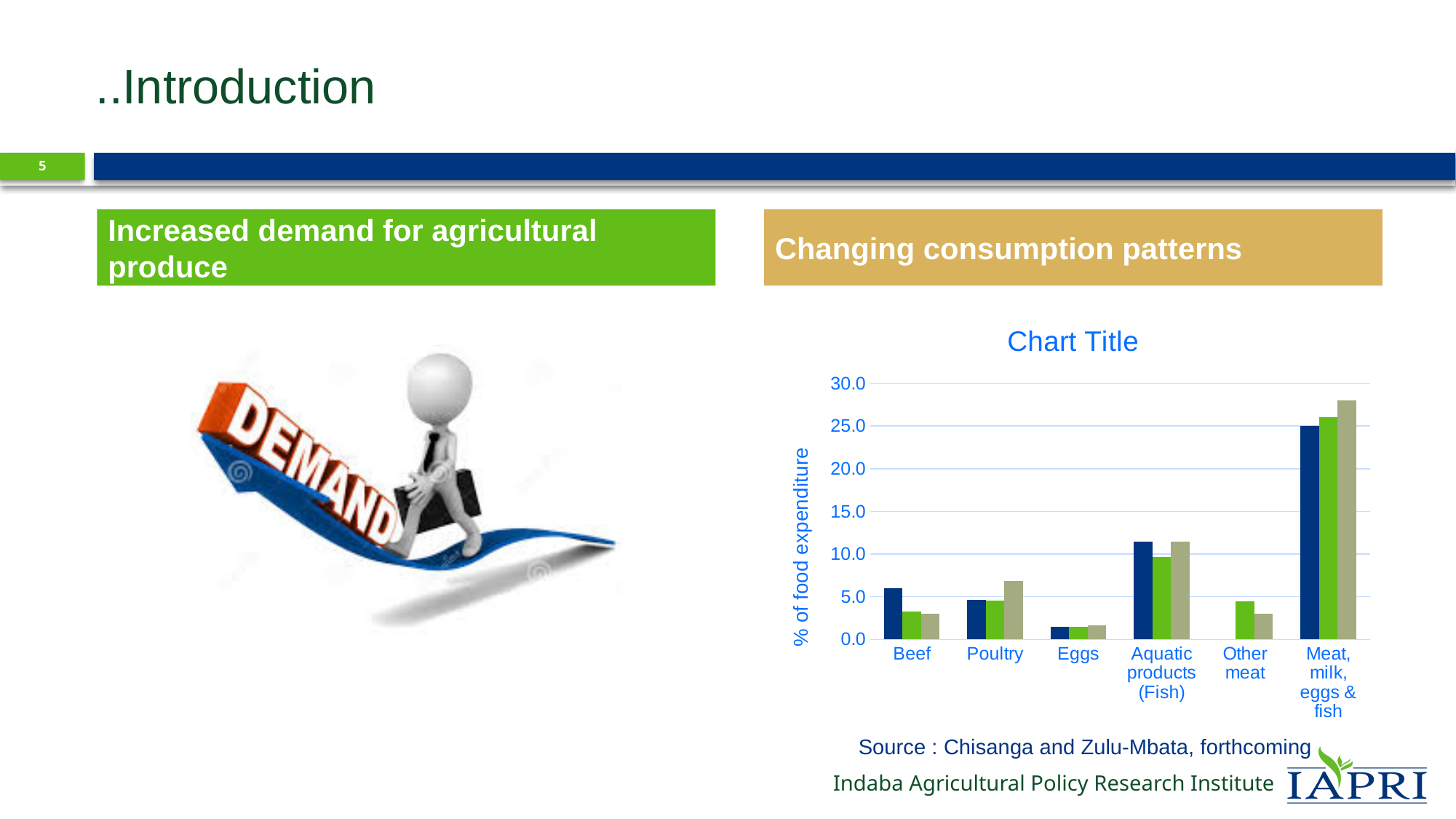
What is the title shown above the chart? Chart Title Which category has larger values, Meat, milk, eggs & fish or Beef? Meat, milk, eggs & fish Is the tan bar for Poultry greater or less than 5.0? greater How many categories are shown on the x axis of the chart? 6 Are the values for Aquatic products (Fish) greater or less than 5.0? greater Are the values for Beef greater or less than 10.0? less What is the label on the y axis of the chart? % of food expenditure Which category has the highest bars in the chart? Meat, milk, eggs & fish What kind of chart is shown on the slide? bar chart Which category has larger values, Aquatic products (Fish) or Poultry? Aquatic products (Fish)